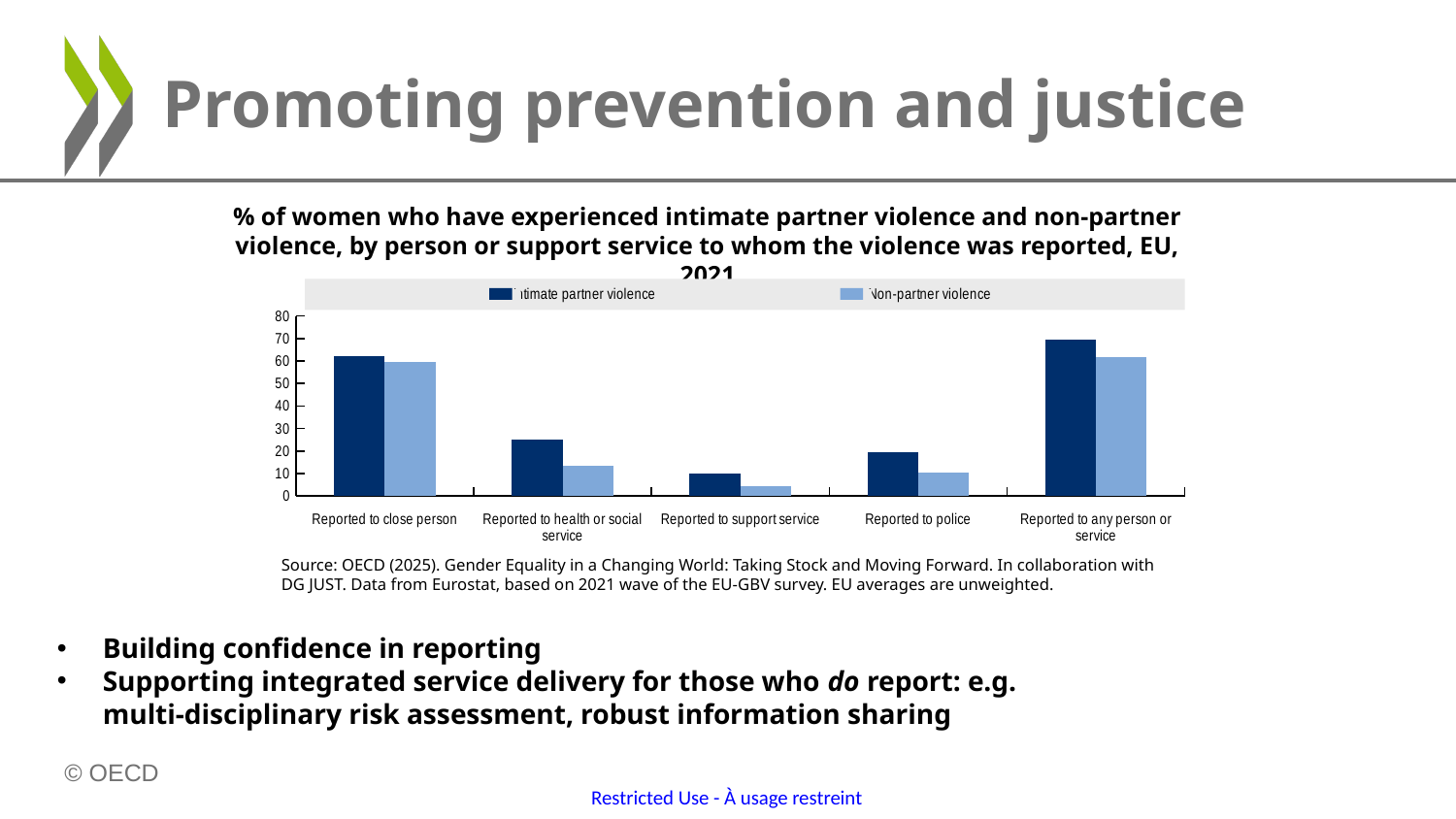
Which is larger: intimate partner violence reported to police or intimate partner violence reported to close person? reported to close person Is the value for non-partner violence reported to support service greater or less than 10? less Is the value for non-partner violence reported to health or social service greater or less than 20? less For reporting to health or social service, which is larger: intimate partner violence or non-partner violence? intimate partner violence Which category has the highest value for intimate partner violence? Reported to any person or service Which category has the lowest value for non-partner violence? Reported to support service Which colour represents non-partner violence in the chart? light blue Is the value for intimate partner violence reported to any person or service greater or less than 60? greater How many series does the legend list? 2 What kind of chart is shown on the slide? bar chart How many categories are shown on the x axis? 5